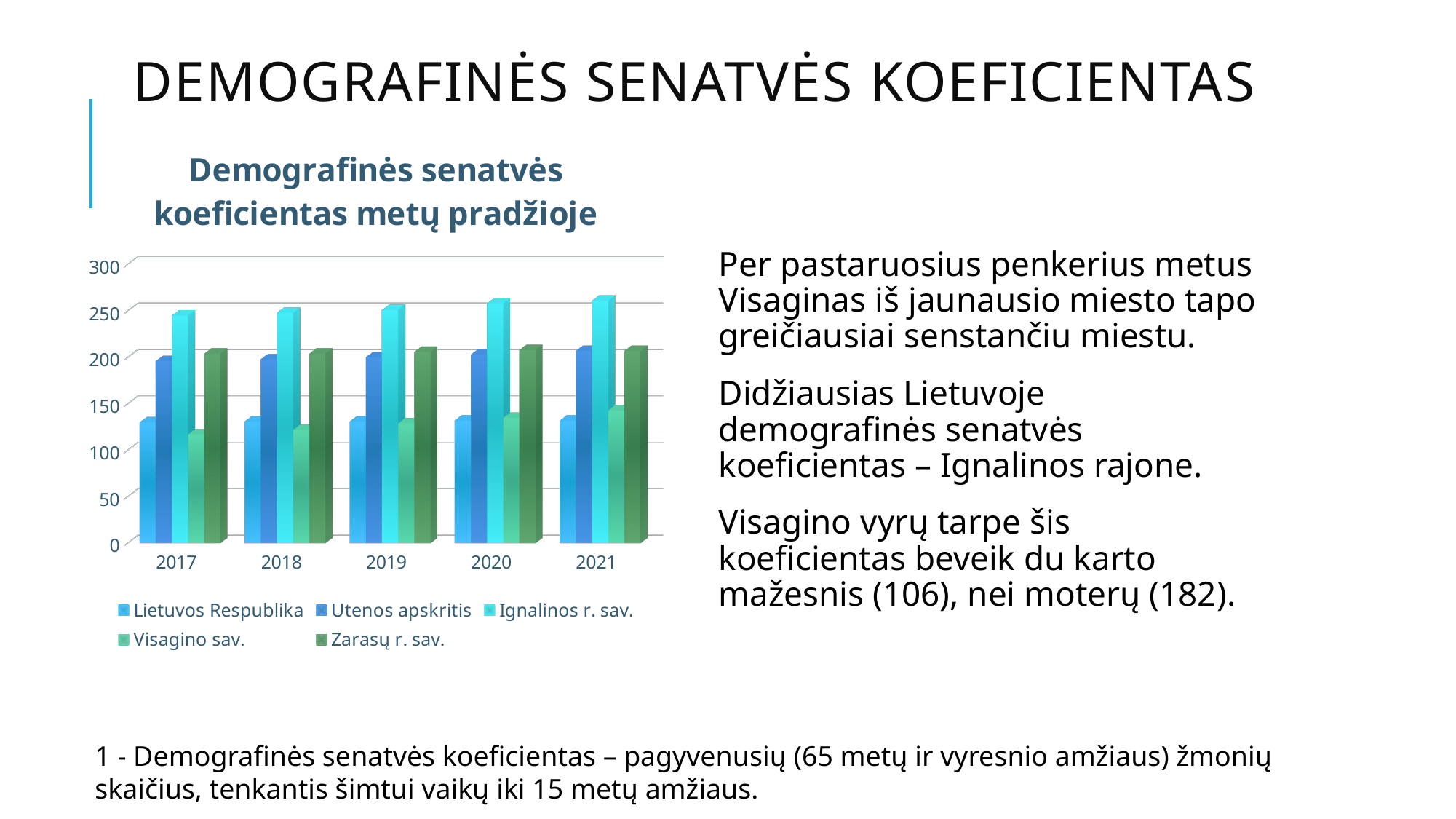
Which series has the lowest value in 2017? Visagino sav. Which is larger in 2019: the value for Ignalinos r. sav. or the value for Lietuvos Respublika? Ignalinos r. sav. Is the value for Ignalinos r. sav. in 2021 greater or less than 250? greater What kind of chart is shown on the slide? bar chart What is the title of the chart? Demografinės senatvės koeficientas metų pradžioje Which series is shown in dark green in the chart? Zarasų r. sav. Is the value for Zarasų r. sav. in 2020 greater or less than 200? greater How many series does the chart legend list? 5 How many years are shown on the x axis of the chart? 5 Is the value for Visagino sav. in 2017 greater or less than 150? less Which series has the highest value in 2021? Ignalinos r. sav. Do the values for Visagino sav. rise or fall from 2017 to 2021? rise